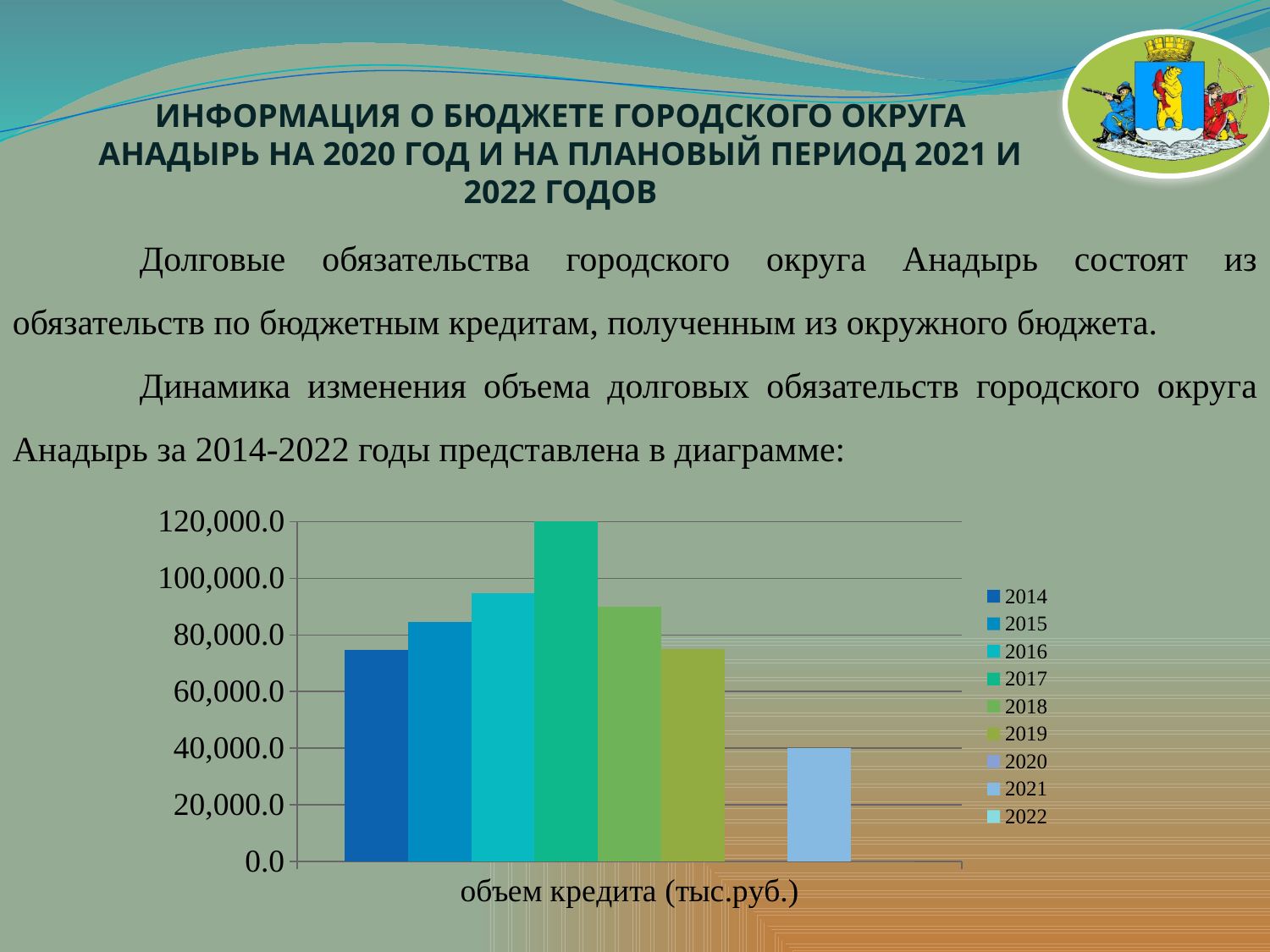
What is the value of the bar for 2017? 120,000.0 Which is larger, the bar for 2015 or the bar for 2019? 2015 Which is larger, the bar for 2016 or the bar for 2018? 2016 Is the value for 2018 greater or less than 80,000.0? greater What is the difference between the bars for 2017 and 2021? 80,000.0 Which year has the highest bar in the chart? 2017 Is the value for 2016 greater or less than 100,000.0? less What is the label shown on the horizontal axis of the chart? объем кредита (тыс.руб.) What is the value of the bar for 2021? 40,000.0 Is the value for 2014 greater or less than 80,000.0? less What kind of chart is shown on the slide? bar chart How many series does the chart legend list? 9